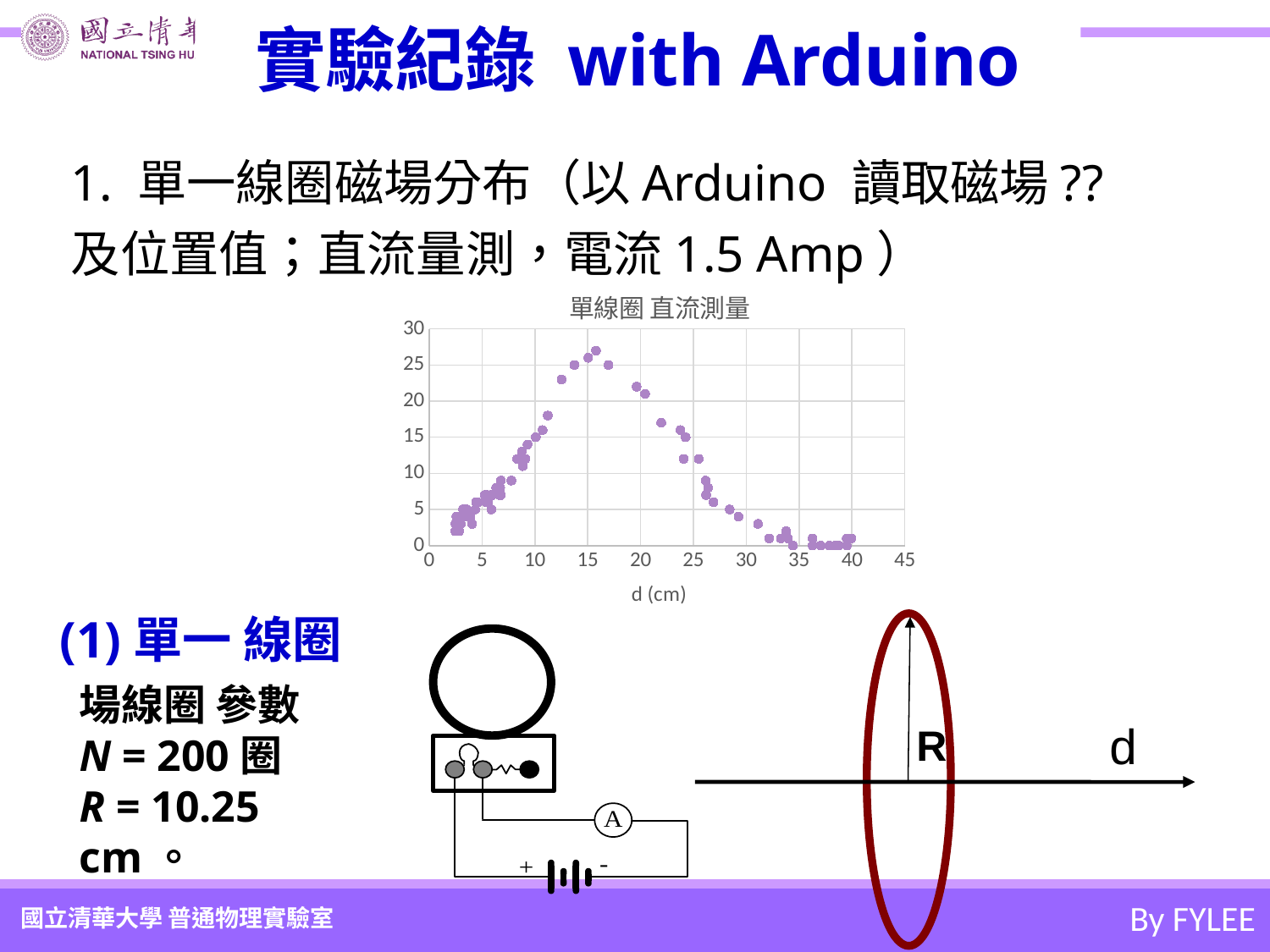
What is the label of the x axis of the chart? d (cm) Do the plotted values rise or fall as d increases from 20 cm to 40 cm? fall Is the value plotted at d = 5 cm greater or less than 10? less What kind of chart is shown on the slide? scatter chart Is the highest plotted value in the chart greater or less than 25? greater Is the value plotted at d = 15 cm larger or smaller than the value plotted at d = 35 cm? larger Is the value plotted at d = 40 cm greater or less than 5? less Do the plotted values rise or fall as d increases from 0 cm to 15 cm? rise What is the title of the chart? 單線圈 直流測量